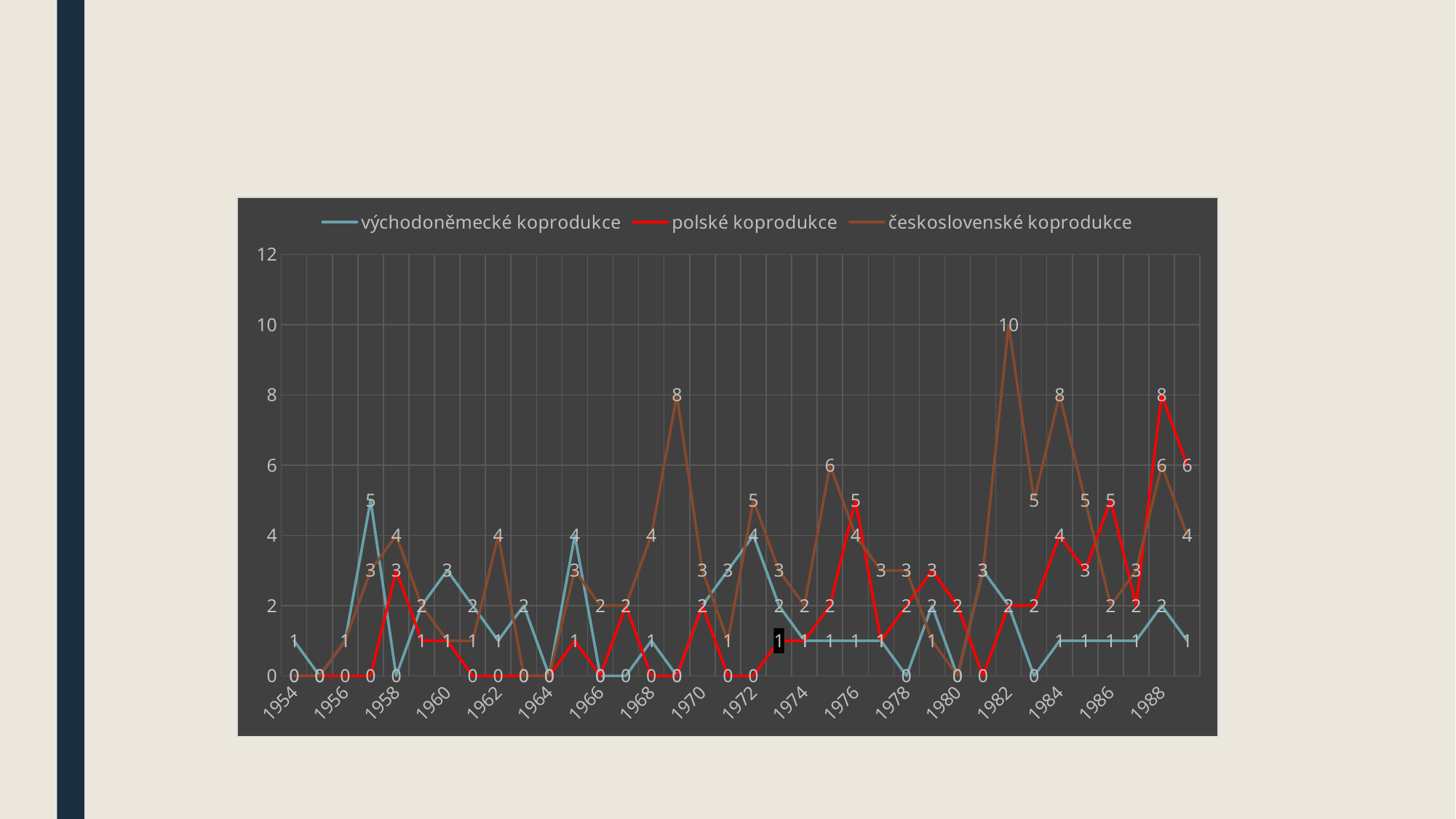
What is the value for polské koprodukce in 1988? 8 What is the difference between československé koprodukce and polské koprodukce in 1982? 8 How many series does the legend list? 3 What is the value for československé koprodukce in 1982? 10 What is the value for polské koprodukce in 1976? 5 In which year does československé koprodukce reach its highest value? 1982 What kind of chart is shown on the slide? line chart Is the value for československé koprodukce in 1982 greater or less than 8? greater What is the value for československé koprodukce in 1969? 8 In which year does polské koprodukce reach its highest value? 1988 Which series is listed first in the legend? východoněmecké koprodukce Which series has the higher value in 1988, polské koprodukce or československé koprodukce? polské koprodukce